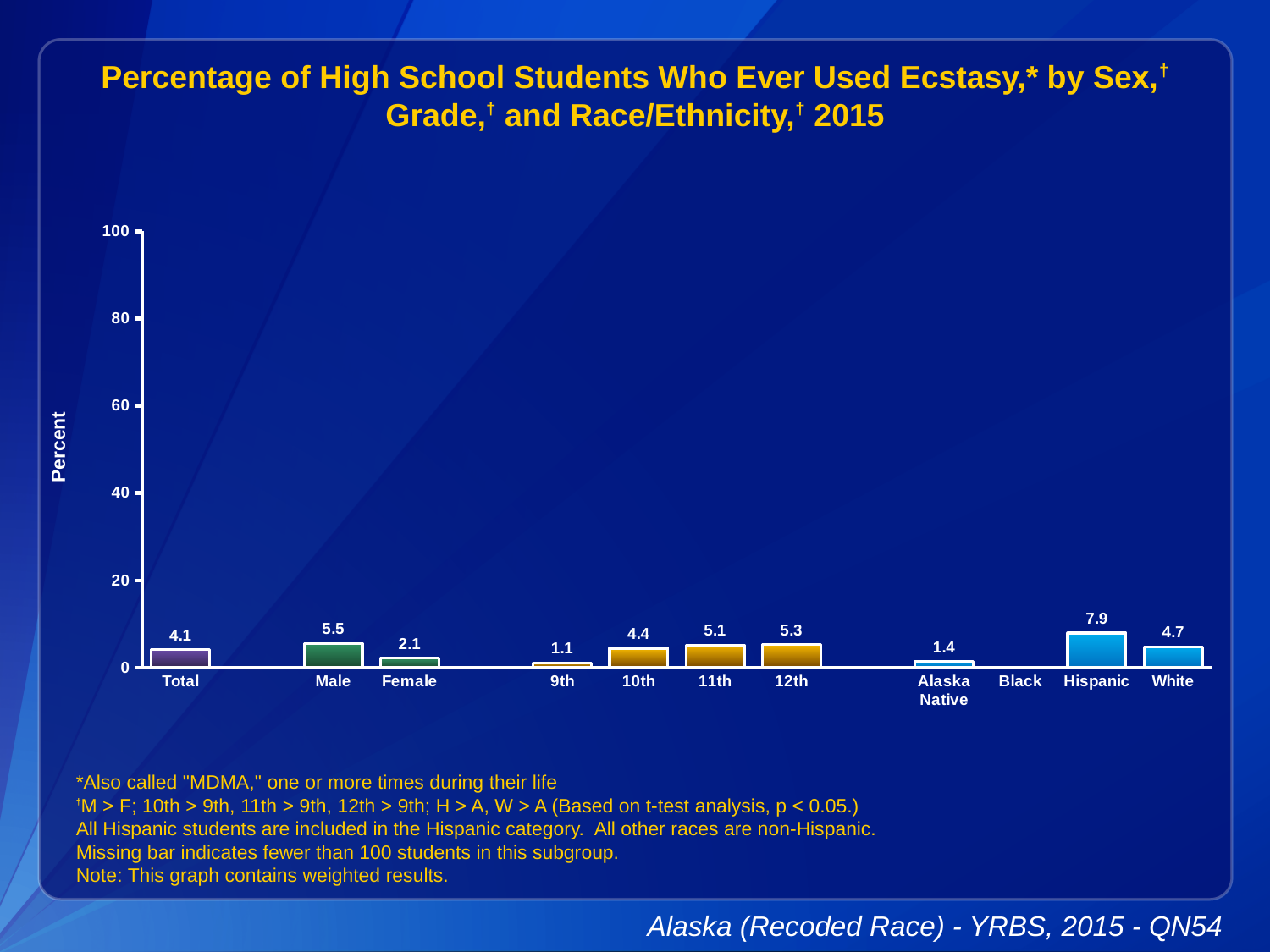
Which category has the highest value? Hispanic How many categories are labeled on the x axis? 11 What is the value for Total? 4.1 What is the value for Hispanic students? 7.9 What is the value for 9th grade? 1.1 What kind of chart is shown? bar chart What is the difference between the Male and Female values? 3.4 What is the value for Male? 5.5 Which is larger, the value for 12th grade or the value for 10th grade? 12th Which category has the lowest value among those with a bar shown? 9th Which category has no bar shown? Black Is the value for White greater or less than 20? less